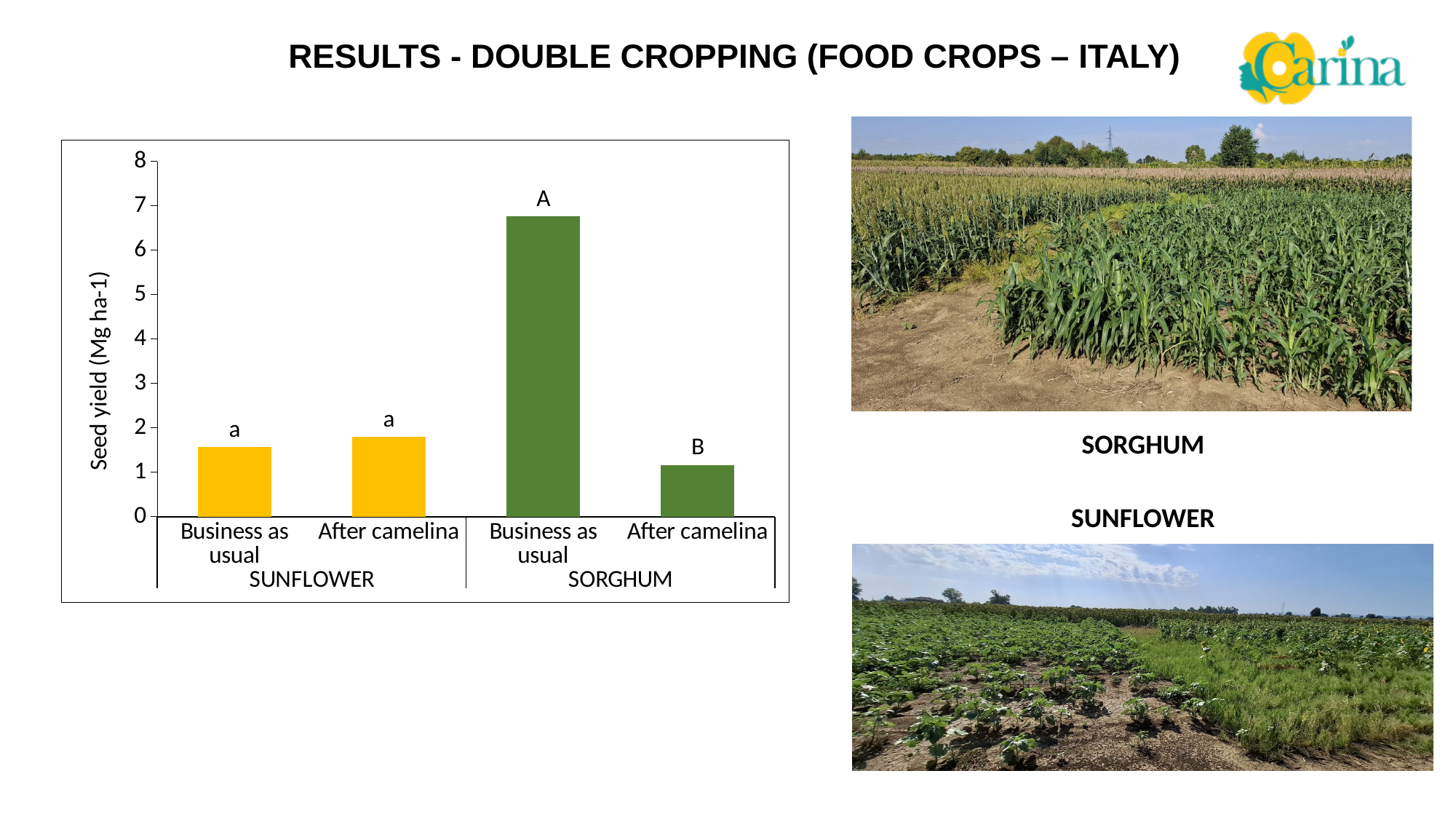
For sorghum, which has the larger seed yield: Business as usual or After camelina? Business as usual What is the label of the y axis of the chart? Seed yield (Mg ha-1) Which bar has the lowest seed yield? Sorghum, After camelina What kind of chart is shown on the slide? bar chart Is the seed yield for sunflower After camelina greater or less than 2? less Is the seed yield for sorghum Business as usual greater or less than 6? greater Is the seed yield for sorghum Business as usual greater or less than 7? less What letter is printed above the sorghum After camelina bar? B How many bars are plotted in the chart? 4 Which bar has the highest seed yield? Sorghum, Business as usual